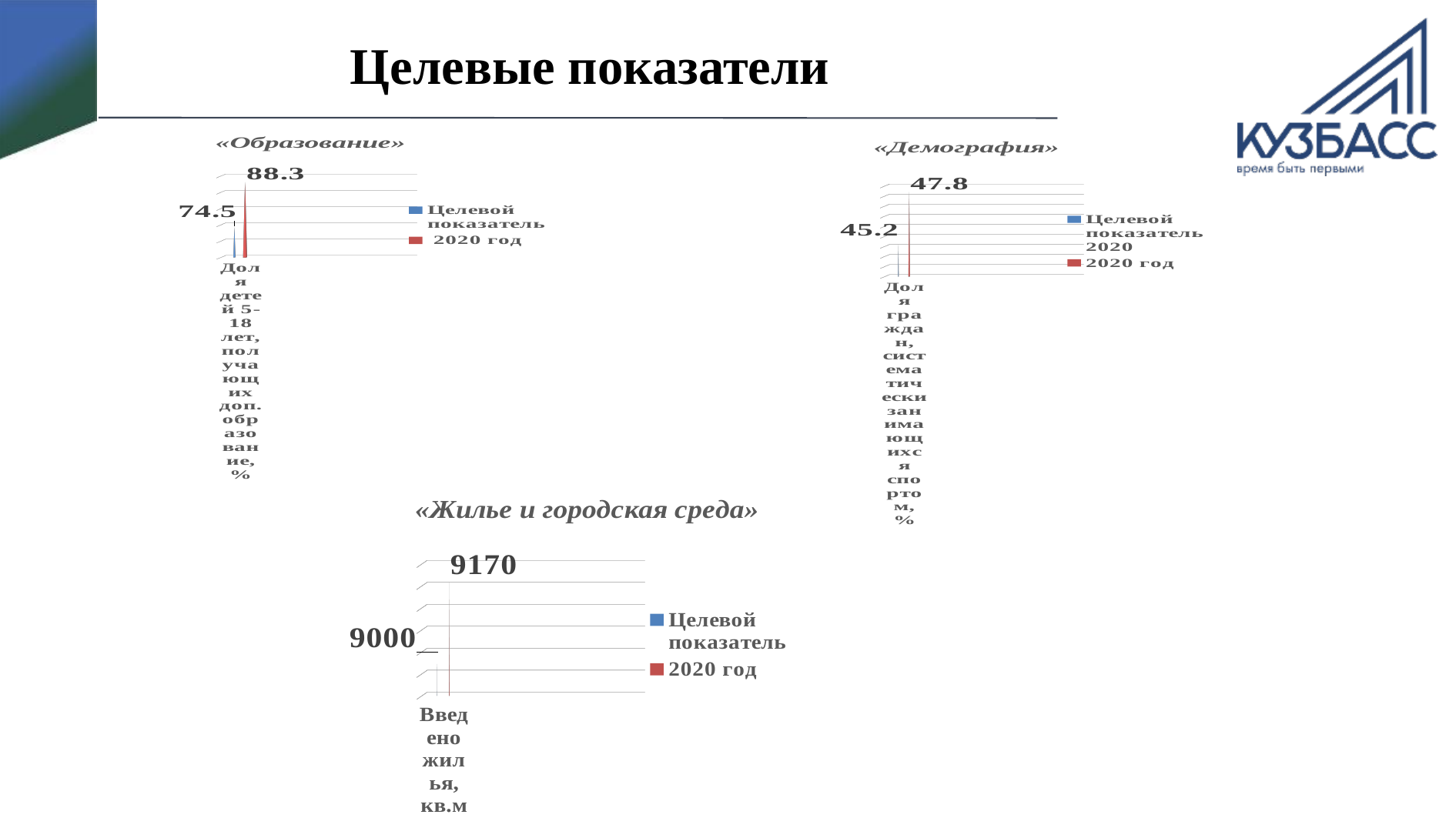
In the «Жилье и городская среда» chart, what is the value for the «Целевой показатель» series? 9000 In the «Образование» chart, which series has the larger value: «Целевой показатель» or «2020 год»? 2020 год In the «Демография» chart, what is the difference between the 2020 value and the target value? 2.6 In the «Образование» chart, what is the value for the «2020 год» series? 88.3 In the «Образование» chart, what is the difference between the 2020 value and the target value? 13.8 In the «Демография» chart, what is the value for the «Целевой показатель 2020» series? 45.2 How many series does the legend of the «Жилье и городская среда» chart list? 2 In the «Жилье и городская среда» chart, what is the value for the «2020 год» series? 9170 In the «Жилье и городская среда» chart, what is the difference between the 2020 value and the target value? 170 What type of chart is the «Демография» chart? Bar chart In the «Образование» chart, what is the value for the «Целевой показатель» series? 74.5 In the «Демография» chart, what is the value for the «2020 год» series? 47.8